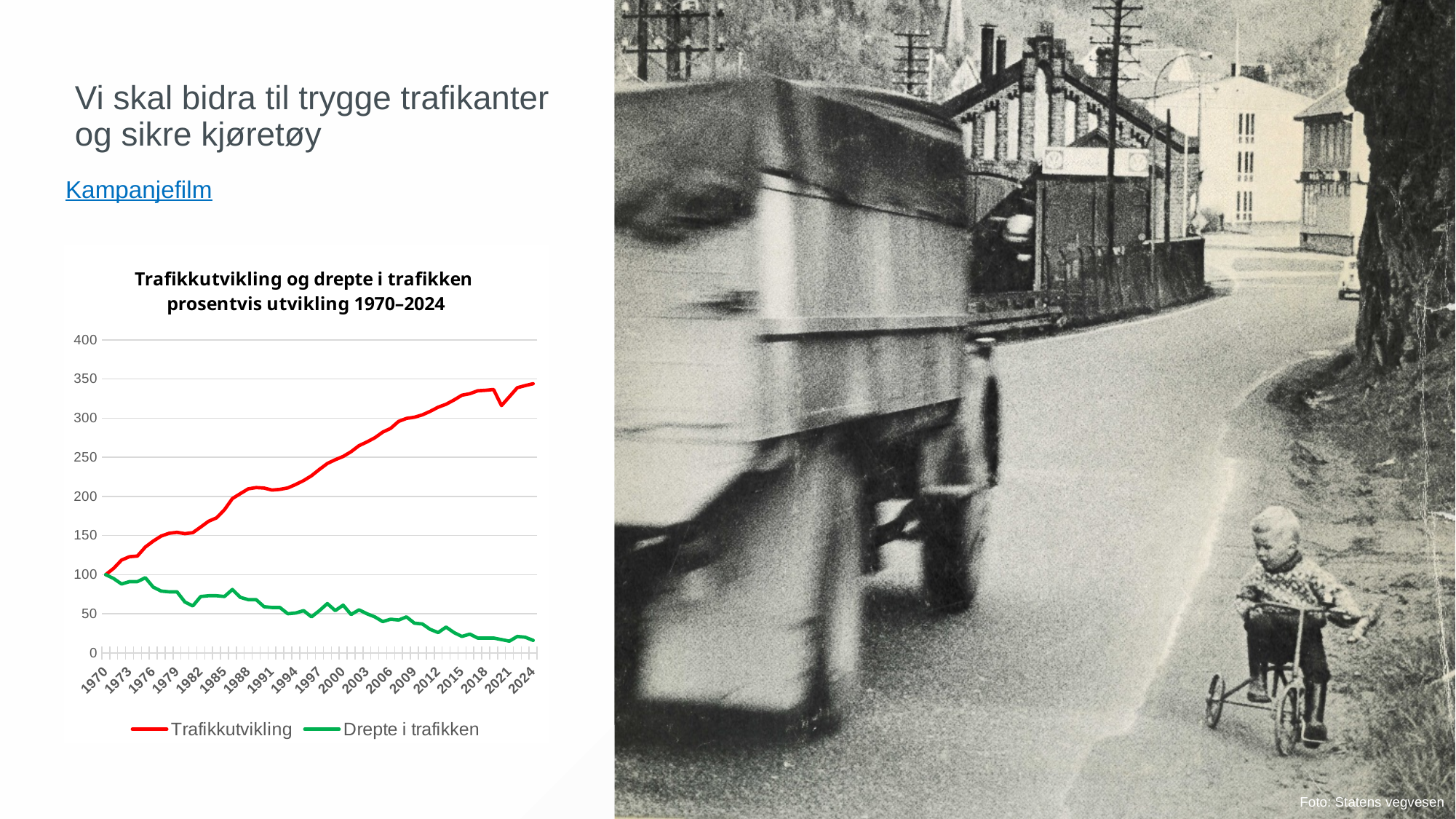
What kind of chart is shown on the slide? line chart What is the title of the chart? Trafikkutvikling og drepte i trafikken prosentvis utvikling 1970–2024 In 2024, which series has the higher value, Trafikkutvikling or Drepte i trafikken? Trafikkutvikling Does the Trafikkutvikling series rise or fall from 1970 to 2024? rise Is the value for Trafikkutvikling in 2024 greater or less than 300? greater Which colour is used for the Drepte i trafikken series? green Does the Drepte i trafikken series rise or fall from 1970 to 2024? fall Is the value for Drepte i trafikken in 1985 greater or less than 50? greater Is the value for Drepte i trafikken in 2024 greater or less than 50? less What is the value of Trafikkutvikling in 1970? 100 How many series does the chart legend list? 2